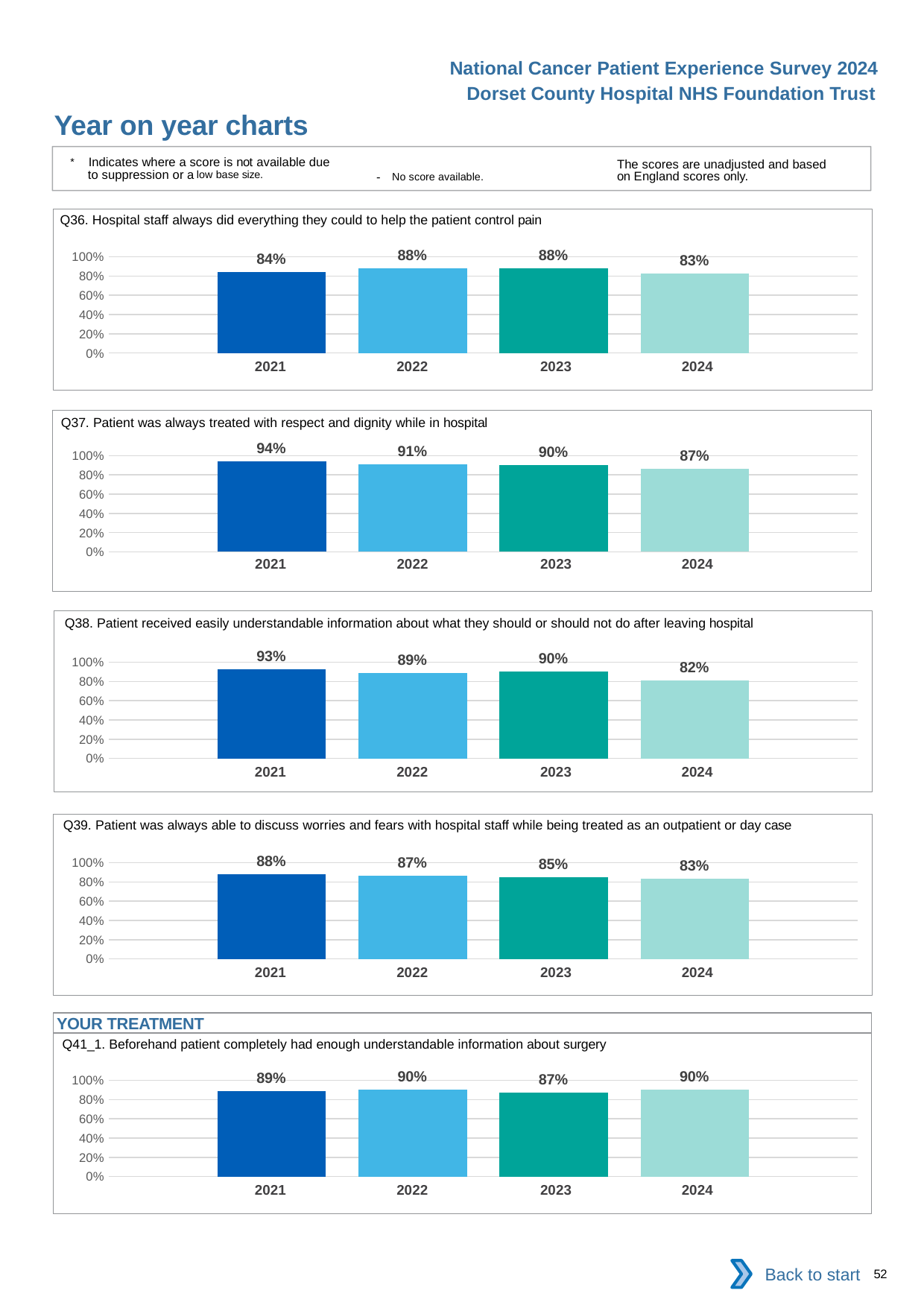
In the Q41_1 chart, is the value for 2024 greater or less than 80%? greater In the Q36 chart, which is larger, the value for 2022 or the value for 2024? 2022 In the Q37 chart, what is the difference between the 2022 and 2023 values? 1 percentage point In the Q39 chart, do the values rise or fall from 2021 to 2024? fall How many years are shown on the x axis of the Q37 chart? 4 In the Q37 chart, which year has the highest value? 2021 In the Q41_1 chart, what is the value for 2023? 87% What is the section heading shown above the Q41_1 chart? YOUR TREATMENT In the Q36 chart, what is the value for 2021? 84% In the Q38 chart, what is the difference between the 2021 and 2024 values? 11 percentage points What kind of chart is the Q39 chart? bar chart In the Q38 chart, which year has the lowest value? 2024